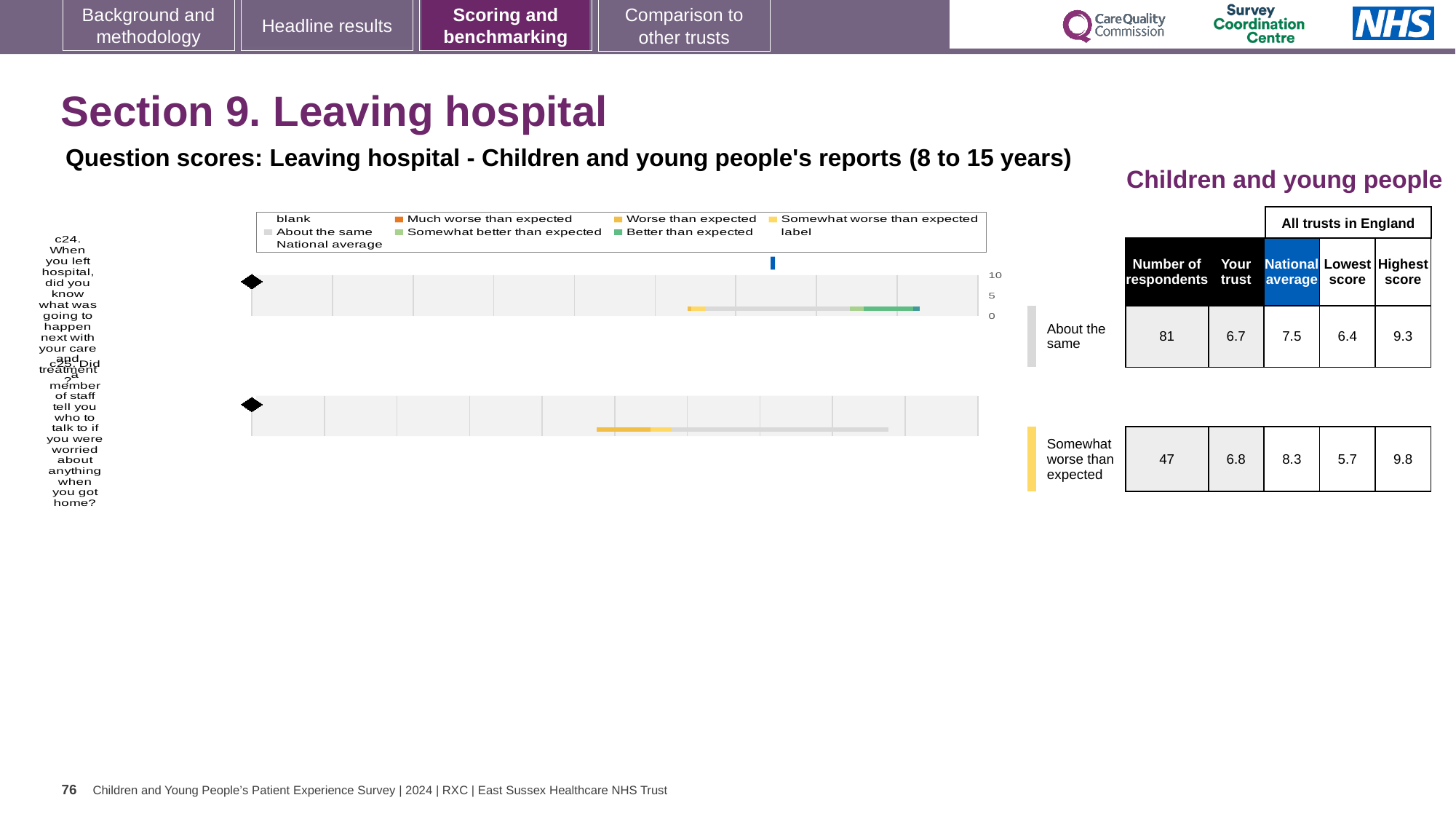
What is the 'Your trust' score for question c24 (did you know what was going to happen next with your care and treatment)? 6.7 Which benchmark category is question c24 placed in? About the same Which benchmark category is question c25 placed in? Somewhat worse than expected How many survey questions are plotted in the Leaving hospital chart? 2 What is the highest score among all trusts in England for question c25? 9.8 What is the difference between the national average and the trust score for question c25? 1.5 Which question has the higher 'Your trust' score, c24 or c25? c25 What is the national average score for question c25 (did a member of staff tell you who to talk to if you were worried)? 8.3 How many respondents answered question c25? 47 How many respondents answered question c24? 81 What kind of chart is used to show the question scores for Leaving hospital? bar chart